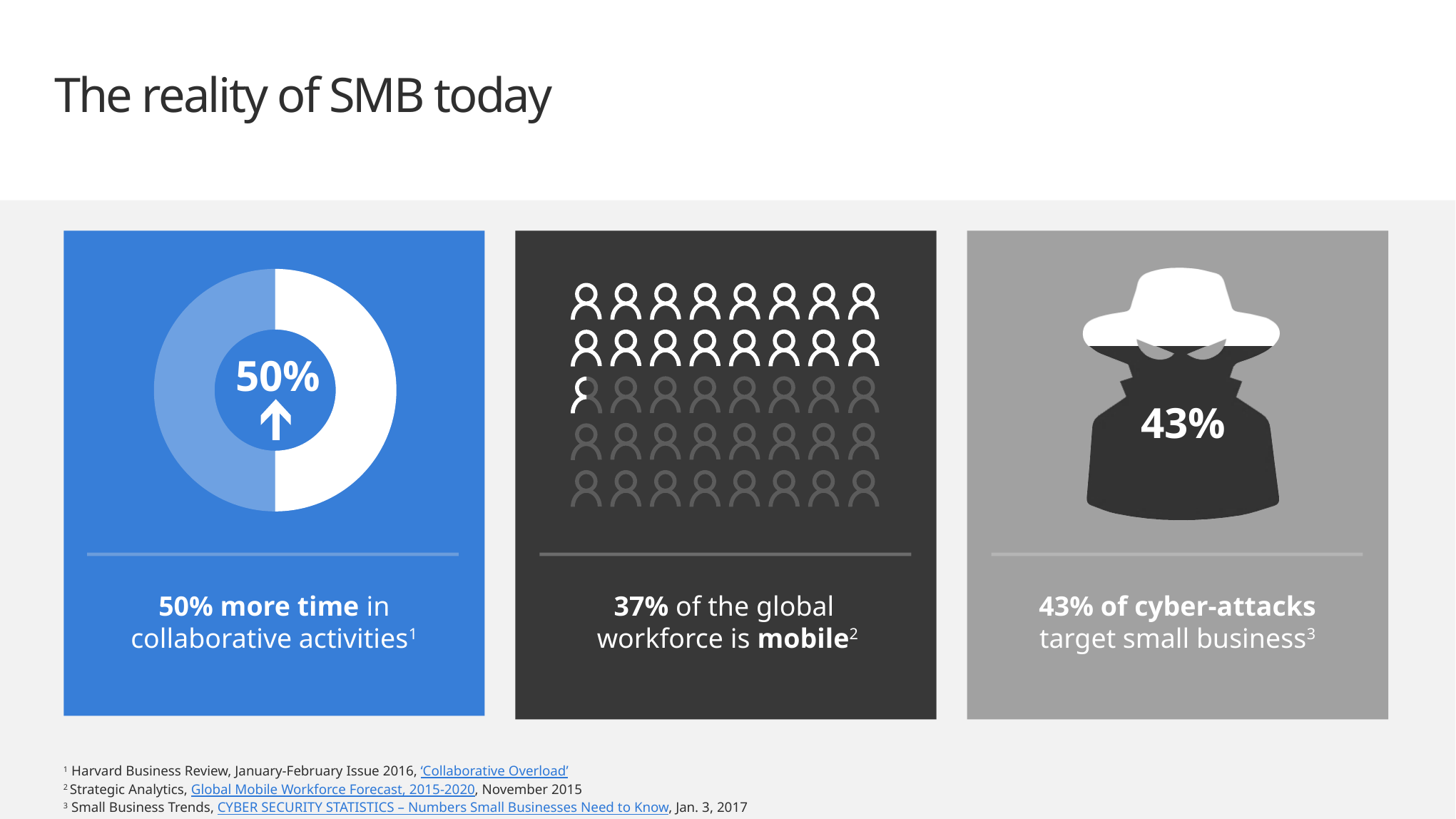
What value is printed in the centre of the donut chart in the left panel? 50% According to the middle panel, what percentage of the global workforce is mobile? 37% What is the title of the slide? The reality of SMB today Which is larger: the share of cyber-attacks targeting small business or the share of the global workforce that is mobile? Cyber-attacks targeting small business (43%) How many person icons are in each row of the pictogram in the middle panel? 8 How many rows of person icons are in the pictogram in the middle panel? 5 Of the three statistics shown on the slide, which is the highest? 50% more time in collaborative activities Of the three statistics shown on the slide, which is the lowest? 37% of the global workforce is mobile What is the difference between the 43% figure in the right panel and the 37% figure in the middle panel? 6 percentage points According to the right panel, what percentage of cyber-attacks target small business? 43% What kind of chart is shown in the left (blue) panel? Donut (pie) chart What is the difference between the 50% figure in the left panel and the 37% figure in the middle panel? 13 percentage points